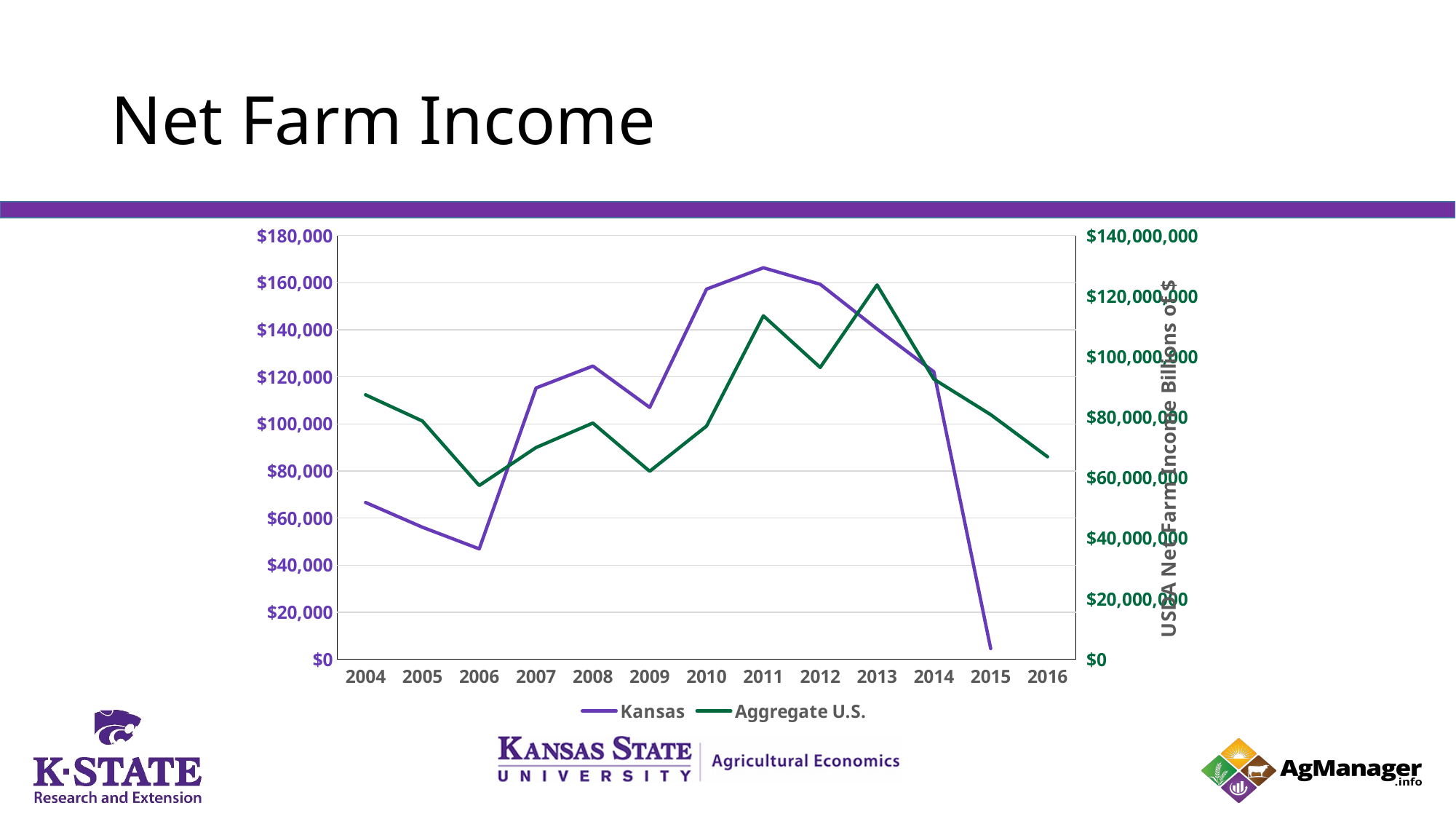
Is the Aggregate U.S. value for 2016 greater or less than $80,000,000? less Does the Kansas series rise or fall from 2011 to 2015? fall What kind of chart is shown on the slide? Line chart How many years are shown on the x axis? 13 Is the Kansas value for 2011 greater or less than $160,000? greater What are the two series named in the legend? Kansas and Aggregate U.S. In which year does the Kansas series reach its lowest value? 2015 In which year does the Aggregate U.S. series reach its lowest value? 2006 How many series does the legend list? 2 Is the Kansas value for 2015 greater or less than $20,000? less In which year does the Aggregate U.S. series reach its highest value? 2013 In which year does the Kansas series reach its highest value? 2011